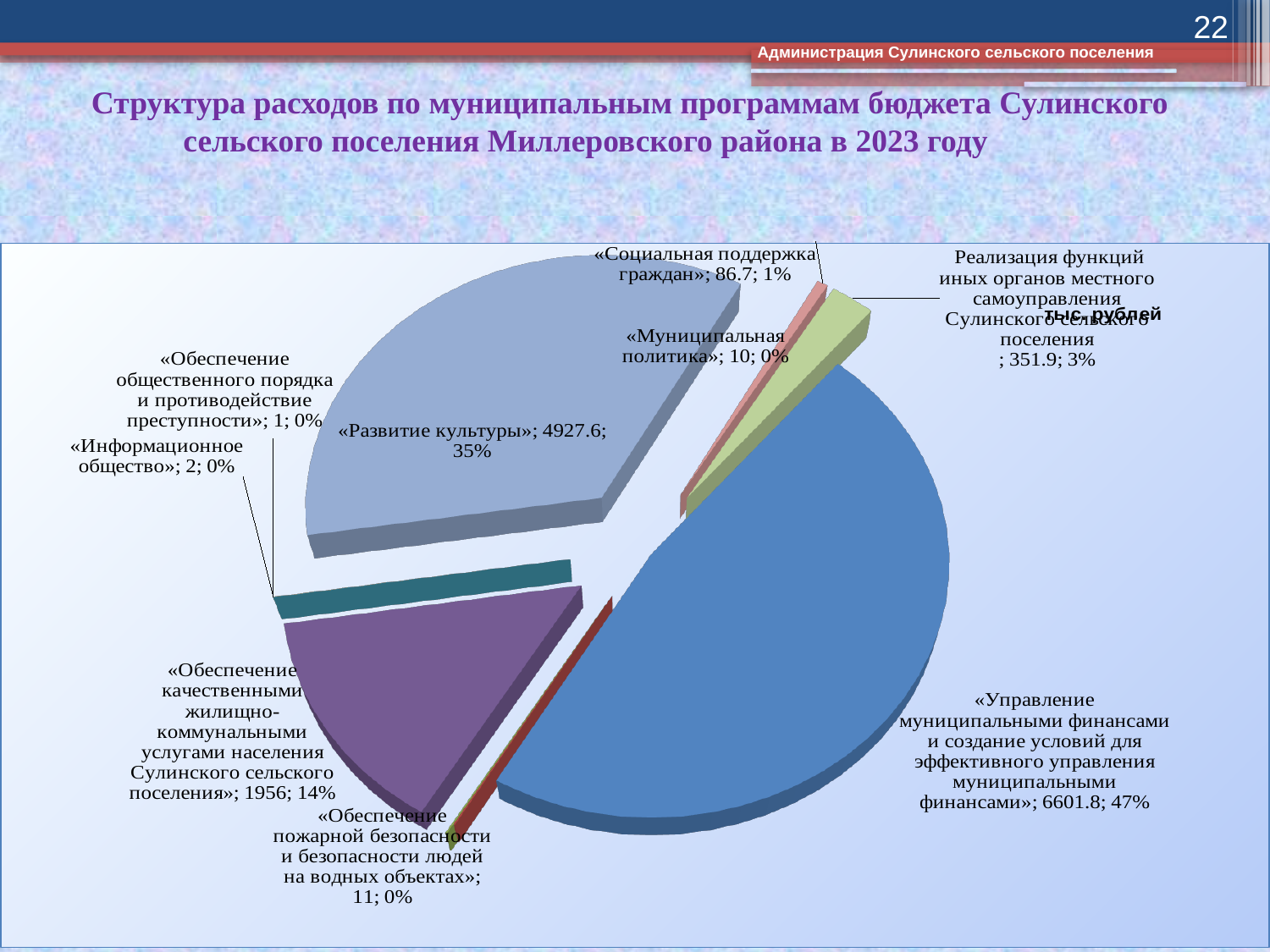
What is the value for «Управление муниципальными финансами и создание условий для эффективного управления муниципальными финансами»? 6601.8 What share of the pie does «Развитие культуры» represent? 35% What is the value for «Социальная поддержка граждан»? 86.7 What share of the pie does «Обеспечение качественными жилищно-коммунальными услугами населения Сулинского сельского поселения» represent? 14% What is the value for Реализация функций иных органов местного самоуправления Сулинского сельского поселения? 351.9 How many slices does the pie chart have? 9 In what units are the values on the chart given? тыс. рублей What kind of chart is shown on the slide? pie chart Which category has the smallest value? «Обеспечение общественного порядка и противодействие преступности» What is the value for «Развитие культуры»? 4927.6 What is the difference between the values for «Управление муниципальными финансами...» (6601.8) and «Развитие культуры» (4927.6)? 1674.2 Which category has the largest value? «Управление муниципальными финансами и создание условий для эффективного управления муниципальными финансами»